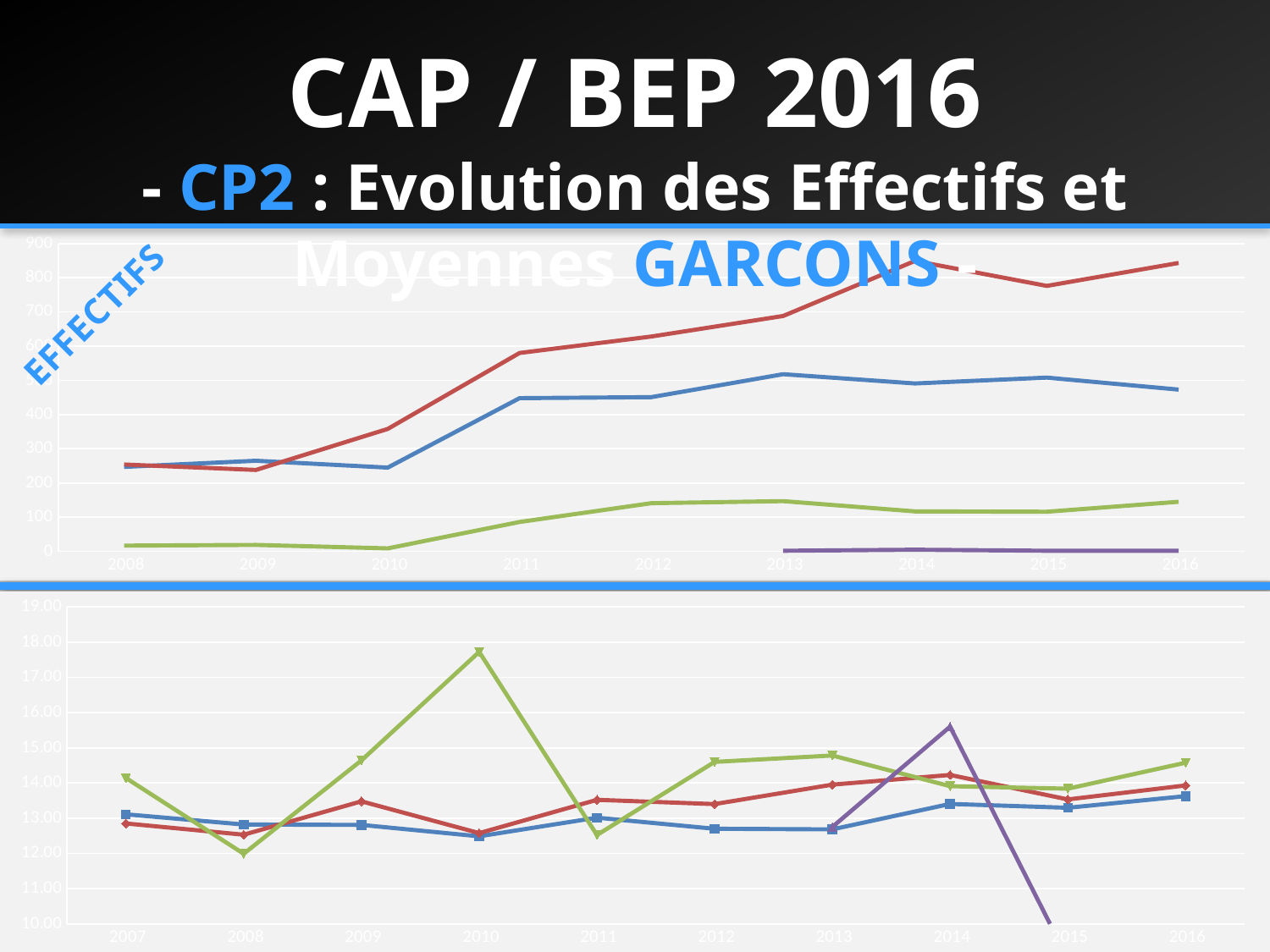
In the bottom chart, in which year does the green line reach its highest value? 2010 In the top chart, does the red line generally rise or fall from 2008 to 2016? rise In the bottom chart, is the value of the green line in 2010 greater or less than 17.00? greater What kind of chart is the top chart on the slide? line chart In the top chart, is the value of the red line in 2016 greater or less than 800? greater In the top chart, which line has the highest value in 2016? the red line In the bottom chart, which line has the lowest value in 2015? the purple line In the top chart, is the value of the blue line in 2016 greater or less than 500? less What kind of chart is the bottom chart on the slide? line chart In the top chart, how many years are shown on the x axis? 9 In the bottom chart, how many years are shown on the x axis? 10